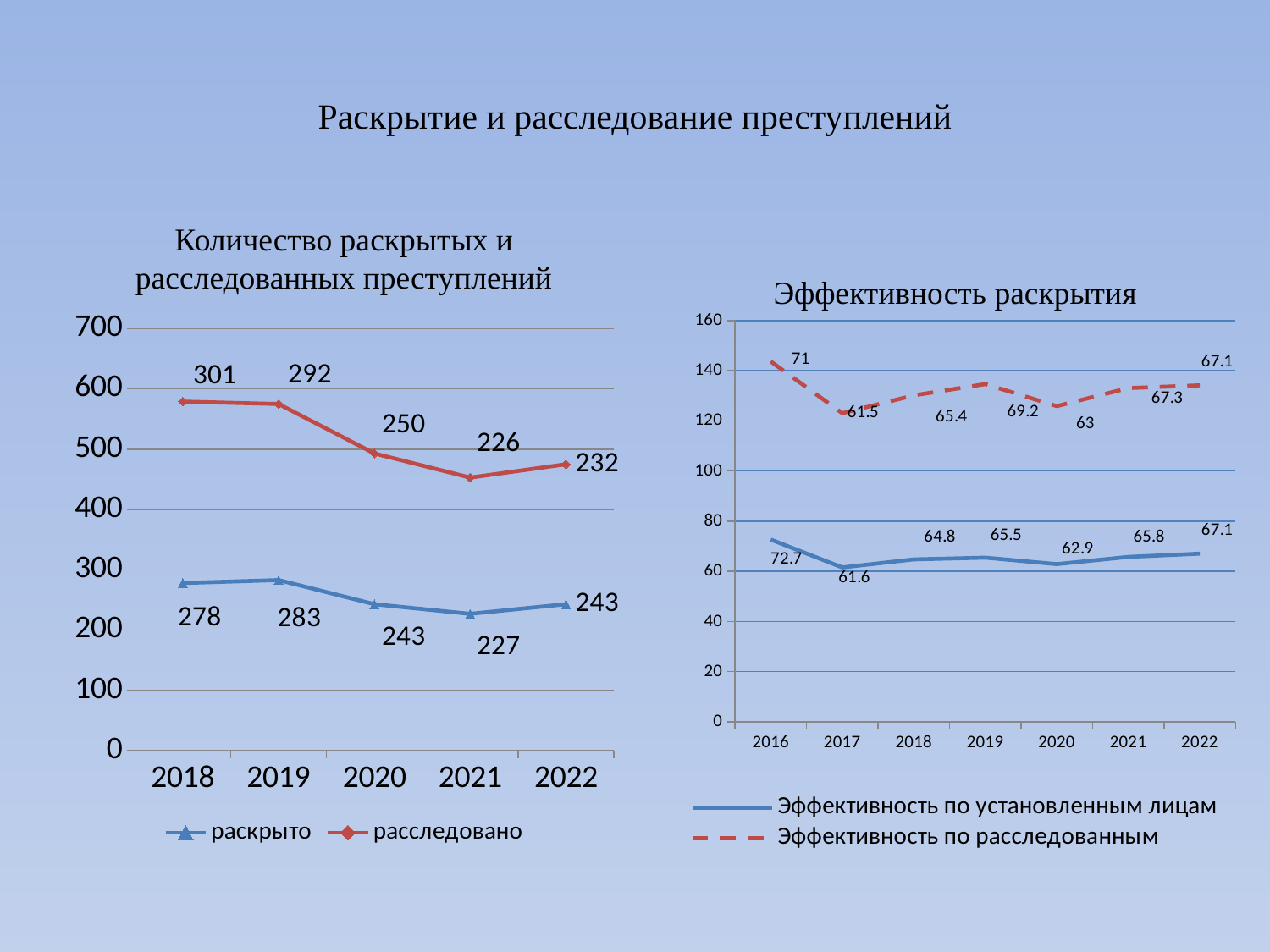
In the chart 'Количество раскрытых и расследованных преступлений', which year has the lowest value for 'расследовано'? 2021 In the chart 'Количество раскрытых и расследованных преступлений', how many years are shown on the x axis? 5 In the chart 'Эффективность раскрытия', how many series does the legend list? 2 In the chart 'Эффективность раскрытия', which year has the lowest value for 'Эффективность по установленным лицам'? 2017 In the chart 'Количество раскрытых и расследованных преступлений', what is the difference between 'расследовано' and 'раскрыто' in 2019? 9 In the chart 'Эффективность раскрытия', what is the value for 'Эффективность по расследованным' in 2019? 69.2 In the chart 'Эффективность раскрытия', which series is drawn with a dashed line? Эффективность по расследованным In the chart 'Эффективность раскрытия', how many years are shown on the x axis? 7 In the chart 'Количество раскрытых и расследованных преступлений', what is the value for 'расследовано' in 2018? 301 In the chart 'Количество раскрытых и расследованных преступлений', what is the value for 'раскрыто' in 2021? 227 In the chart 'Количество раскрытых и расследованных преступлений', what kind of chart is it? line chart In the chart 'Эффективность раскрытия', what is the value for 'Эффективность по установленным лицам' in 2016? 72.7